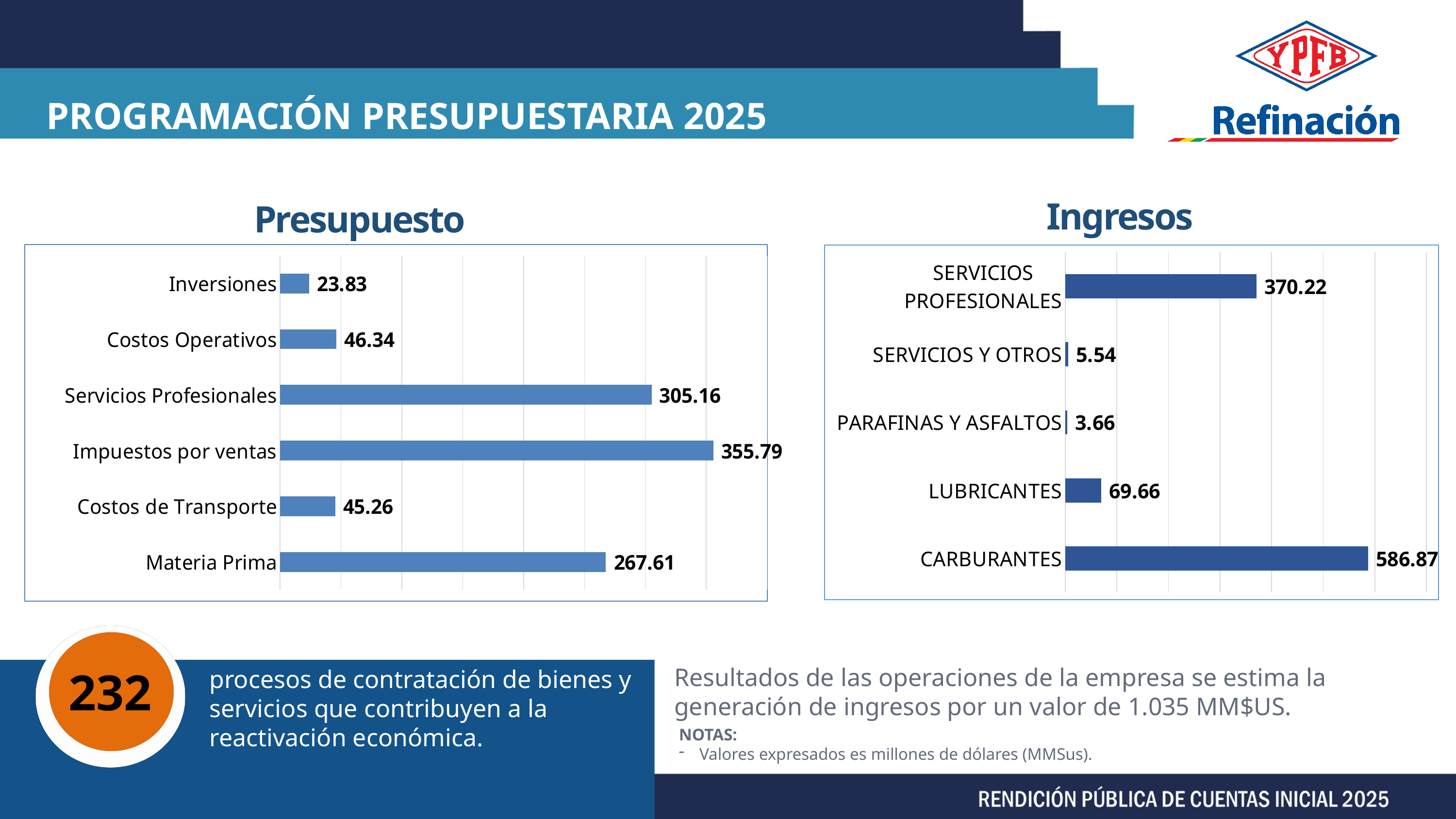
In the Presupuesto chart, which category has the lowest value? Inversiones In the Ingresos chart, which category has the lowest value? PARAFINAS Y ASFALTOS In the Ingresos chart, what is the value for CARBURANTES? 586.87 In the Presupuesto chart, which category has the highest value? Impuestos por ventas In the Presupuesto chart, what is the value for Inversiones? 23.83 What type of chart is the Ingresos chart? Bar chart In the Presupuesto chart, what is the value for Impuestos por ventas? 355.79 In the Presupuesto chart, what is the difference between Impuestos por ventas and Materia Prima? 88.18 In the Ingresos chart, which is larger, SERVICIOS PROFESIONALES or LUBRICANTES? SERVICIOS PROFESIONALES In the Ingresos chart, what is the value for LUBRICANTES? 69.66 In the Presupuesto chart, how many categories are shown? 6 In the Ingresos chart, what is the difference between CARBURANTES and SERVICIOS PROFESIONALES? 216.65